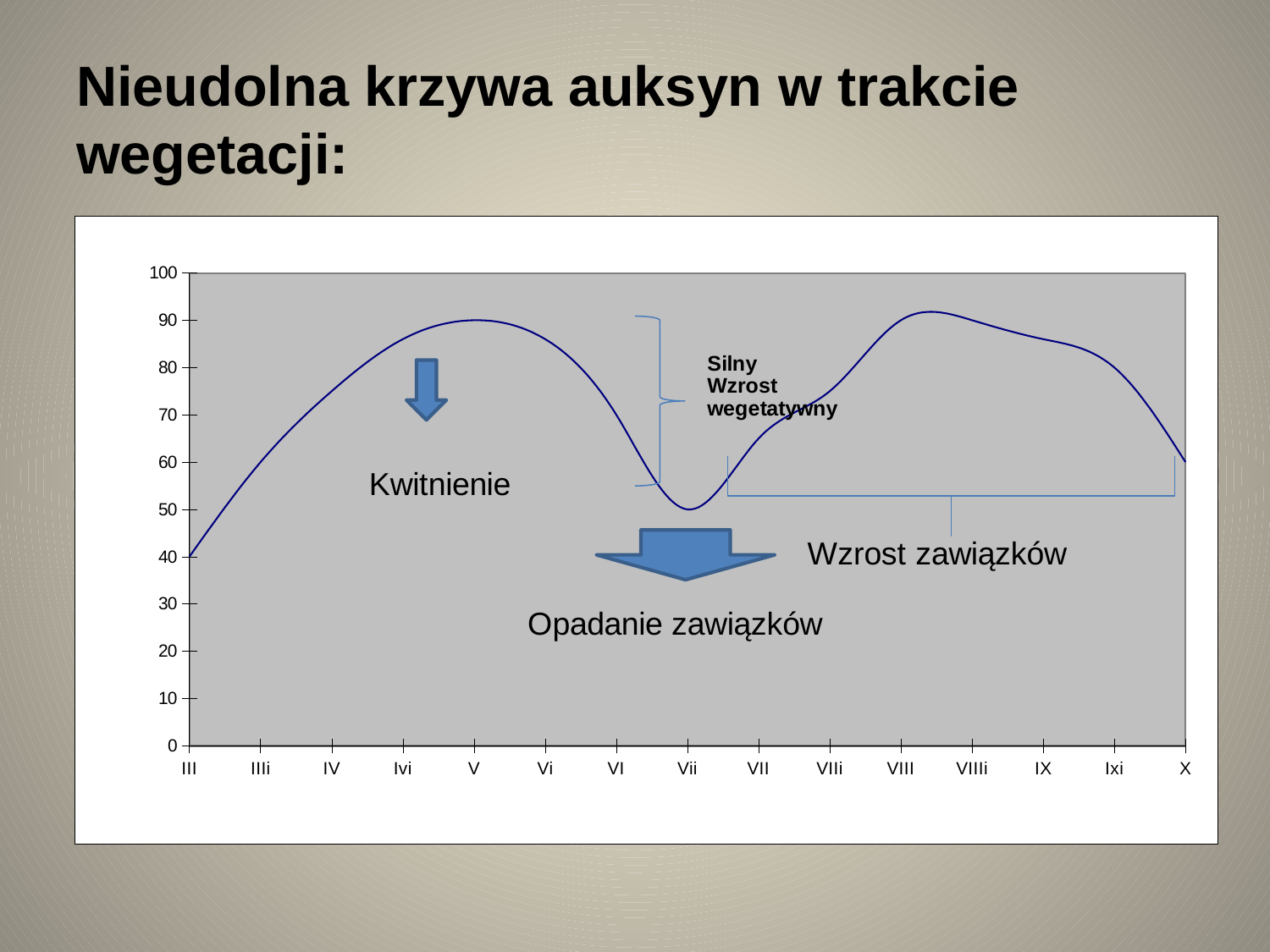
What kind of chart is shown on the slide? line chart Is the value of the curve at Vi greater or less than 80? greater Is the value of the curve at IX greater or less than 70? greater How many categories are labelled on the x axis? 15 Is the value of the curve at VIIi greater or less than 60? greater Does the curve rise or fall from III to V? rises Does the curve rise or fall from V to Vii? falls Which has the larger value on the curve, III or X? X What is the highest value shown on the y axis? 100 Which category on the x axis has the lowest value of the curve? III